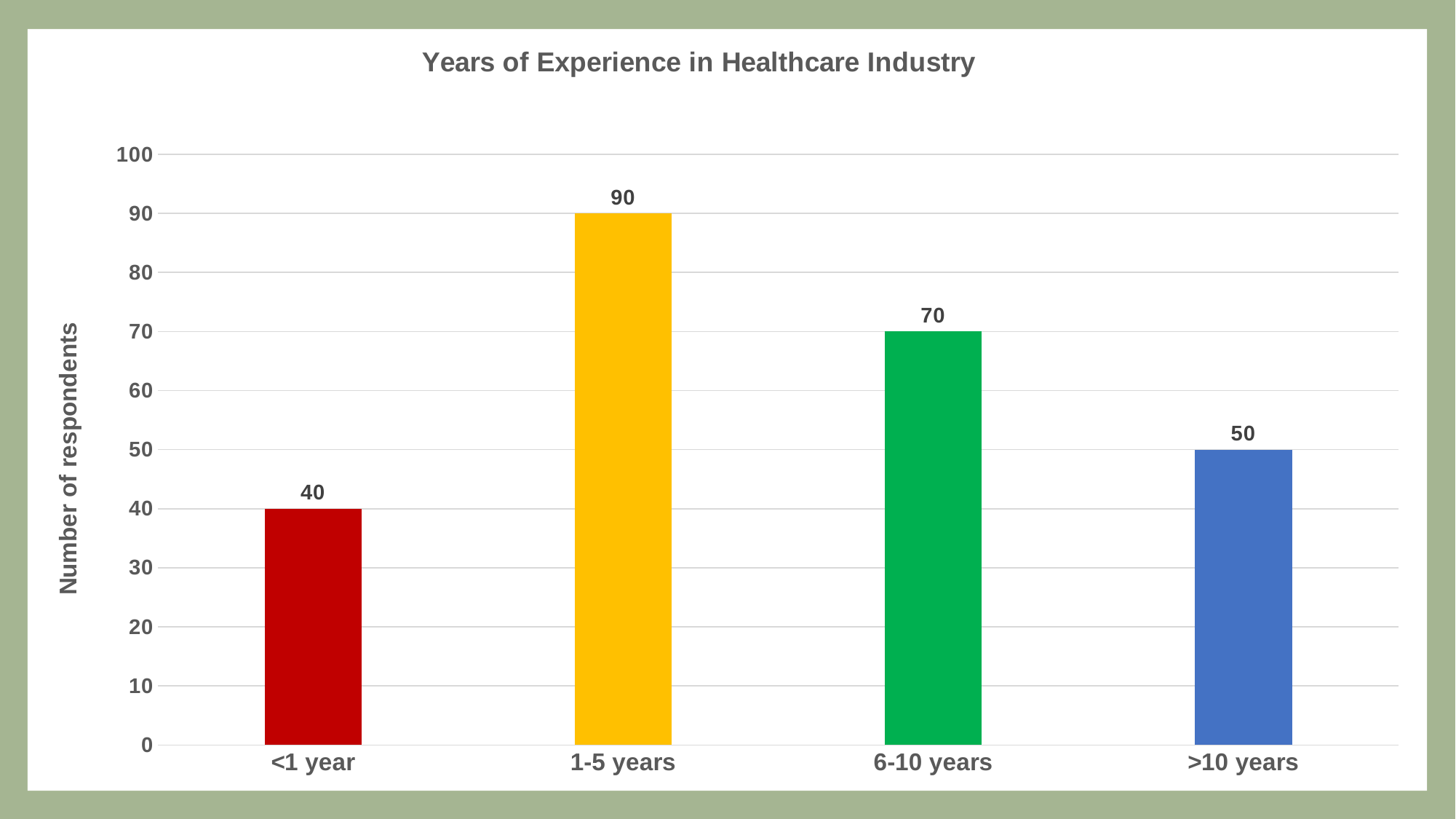
Which experience category has the highest number of respondents? 1-5 years Which has more respondents, 6-10 years or >10 years? 6-10 years What is the title of the chart? Years of Experience in Healthcare Industry Which experience category has the lowest number of respondents? <1 year What is the difference in respondents between the >10 years and <1 year categories? 10 What is the difference in respondents between the 1-5 years and 6-10 years categories? 20 What is the number of respondents with >10 years of experience? 50 Is the value for 6-10 years greater or less than 60? greater How many experience categories are shown on the chart? 4 What is the number of respondents with 1-5 years of experience? 90 What kind of chart is shown on the slide? Bar chart What is the number of respondents with <1 year of experience? 40